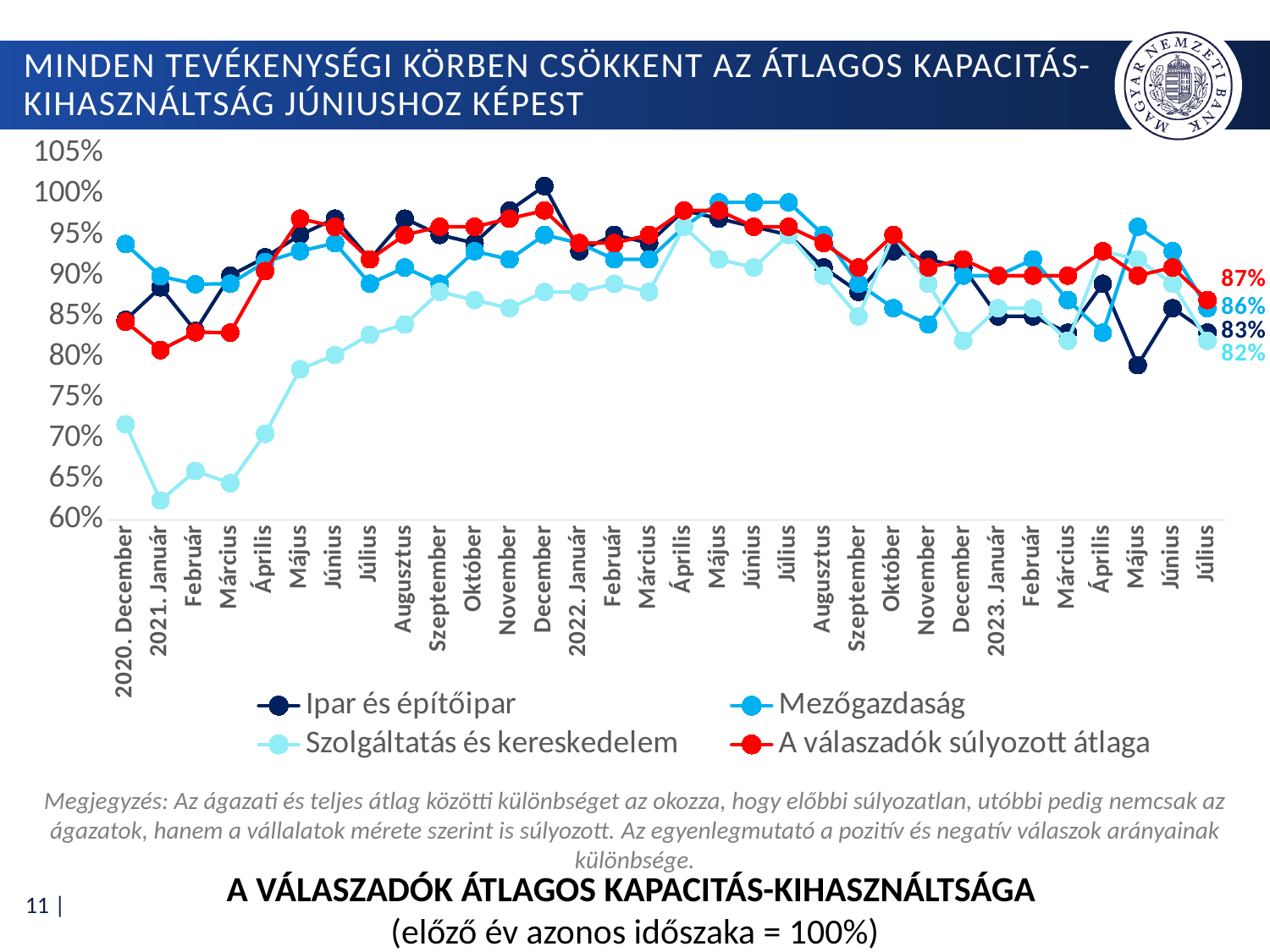
What is the value for 'Mezőgazdaság' in 2023 Július? 86% What is the difference between 'A válaszadók súlyozott átlaga' and 'Szolgáltatás és kereskedelem' in 2023 Július? 5 percentage points Which series has the lowest value in 2023 Július? Szolgáltatás és kereskedelem What is the value for 'A válaszadók súlyozott átlaga' in 2023 Július? 87% Is the value for 'Ipar és építőipar' in 2021 December greater or less than 100%? greater Which series has the highest value in 2023 Július? A válaszadók súlyozott átlaga How many series does the legend list? 4 In 2023 Július, which is larger: 'Mezőgazdaság' or 'Ipar és építőipar'? Mezőgazdaság What is the value for 'Szolgáltatás és kereskedelem' in 2023 Július? 82% What kind of chart is shown on the slide? Line chart Is the value for 'Szolgáltatás és kereskedelem' in 2021 Január greater or less than 65%? less What is the value for 'Ipar és építőipar' in 2023 Július? 83%